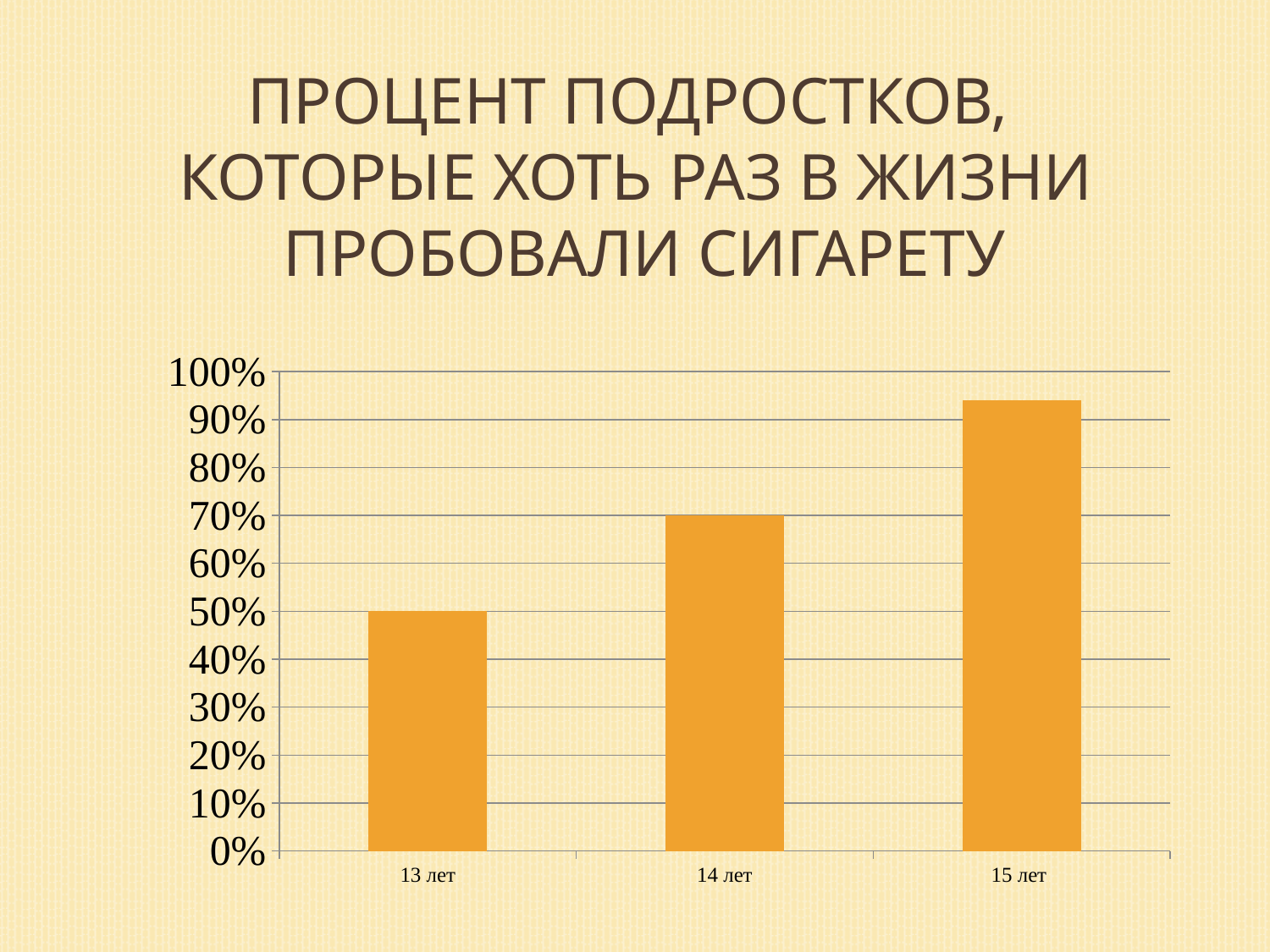
Is the value for 15 лет greater or less than 90%? greater Which is larger, the value for 14 лет or the value for 15 лет? 15 лет How many age categories are shown on the x axis? 3 Do the values rise or fall as age increases along the x axis? rise What is the value for 13 лет? 50% Which age group has the highest value? 15 лет Is the value for 13 лет greater or less than 60%? less What is the maximum value shown on the vertical axis? 100% What kind of chart is shown on the slide? bar chart What is the difference between the values for 14 лет and 13 лет? 20% Which age group has the lowest value? 13 лет What is the value for 14 лет? 70%